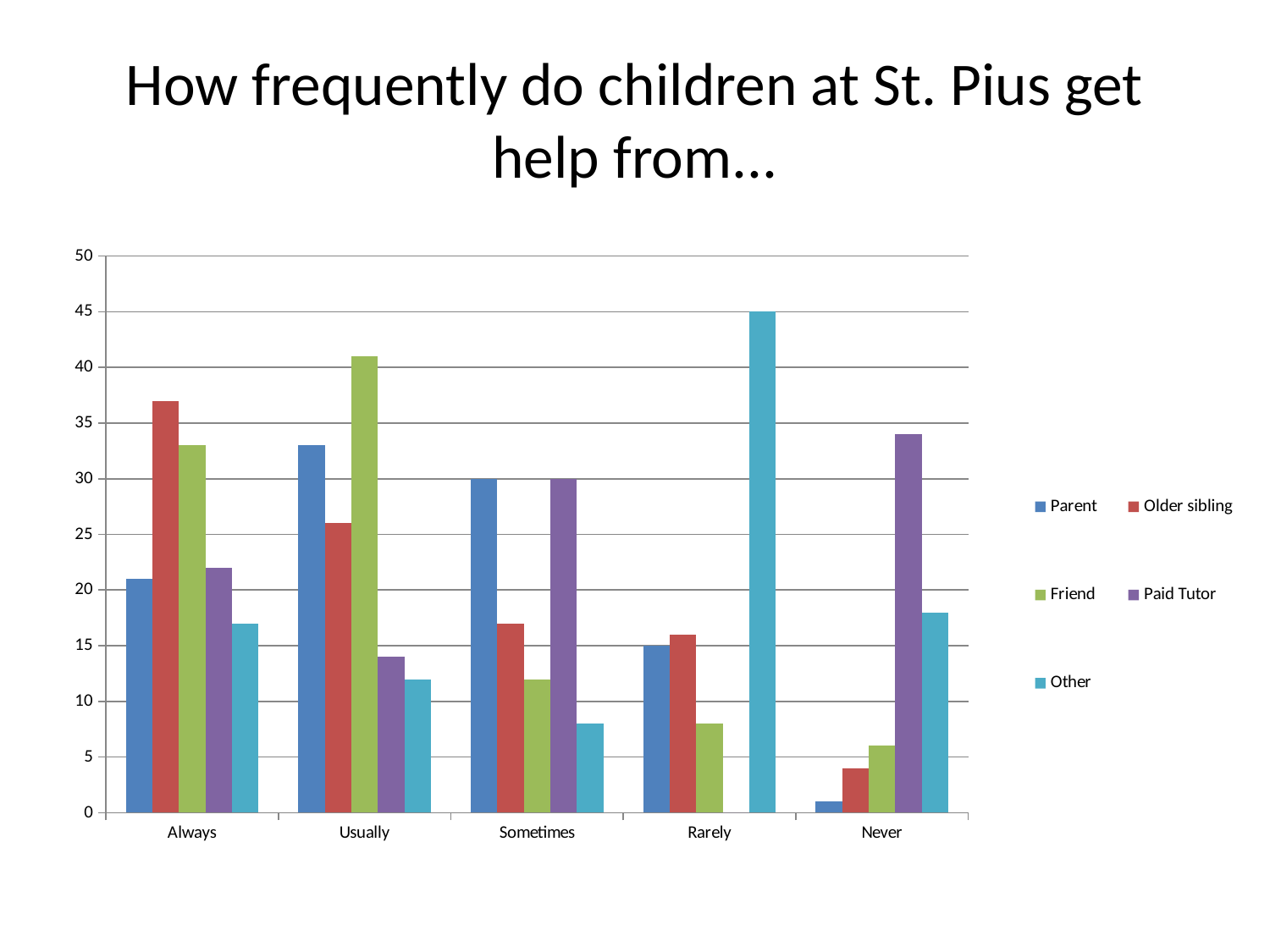
What kind of chart is shown on the slide? bar chart Is the value for Parent in the Never category greater or less than 5? less Is the value for Older sibling in the Always category greater or less than 35? greater Which series has the lowest bar in the Never category? Parent How many frequency categories are shown on the x axis? 5 What is the value for Other in the Rarely category? 45 How many series does the legend list? 5 Which series has the highest bar in the Never category? Paid Tutor What is the value for Paid Tutor in the Sometimes category? 30 What is the title of the chart on the slide? How frequently do children at St. Pius get help from… Which series has the highest bar in the Always category? Older sibling In the Usually category, which is larger: the value for Parent or the value for Older sibling? Parent